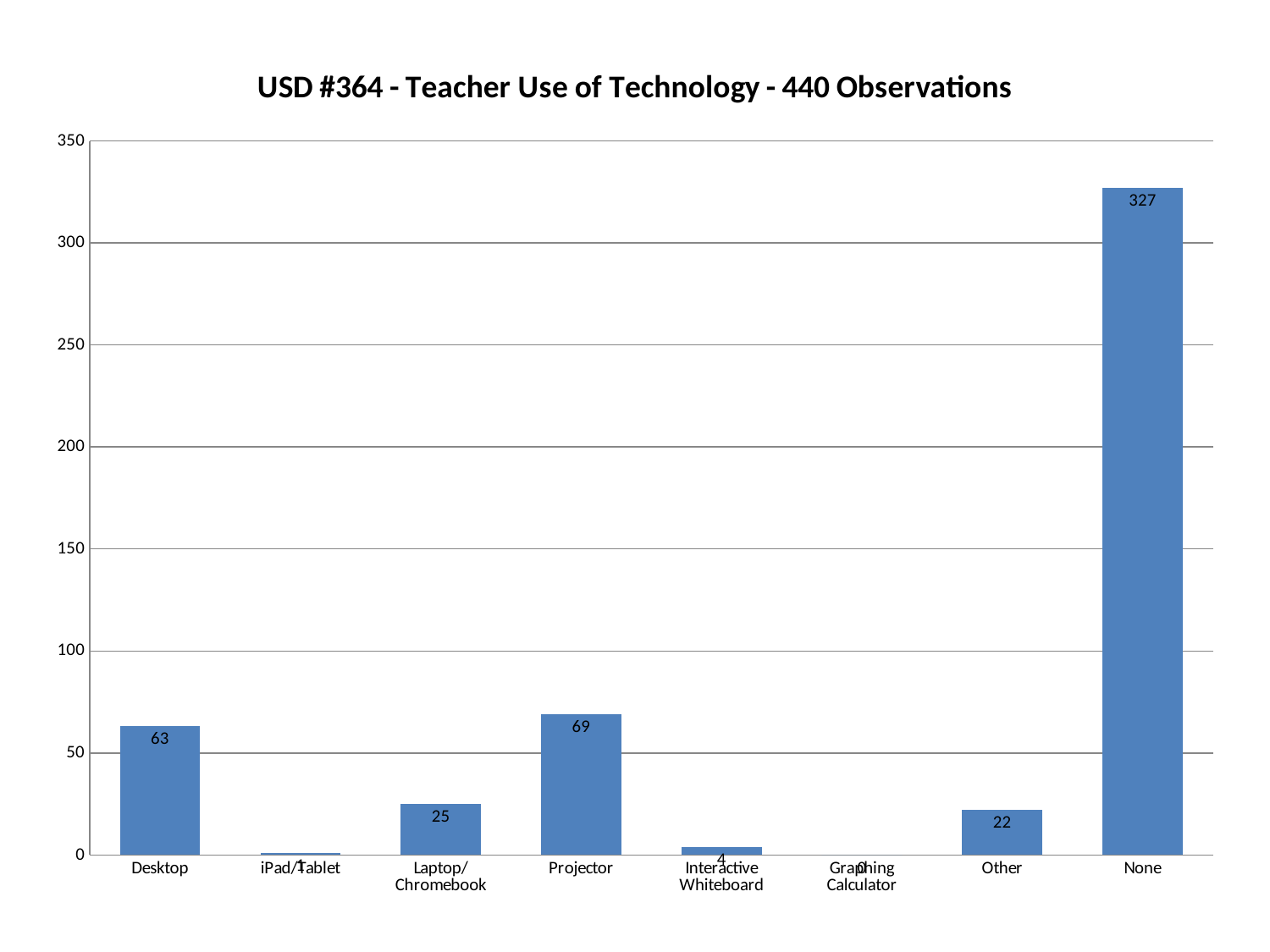
What is the value for None? 327 Which category has the highest value? None What is the difference between the values for Projector and Desktop? 6 What is the value for Projector? 69 What is the value for Desktop? 63 Which category has the lowest value? Graphing Calculator Which is larger, the value for Laptop/Chromebook or the value for Other? Laptop/Chromebook What kind of chart is shown on the slide? Bar chart Is the value for None greater or less than 300? greater What is the value for Laptop/Chromebook? 25 What is the value for Other? 22 How many categories are shown on the x axis? 8